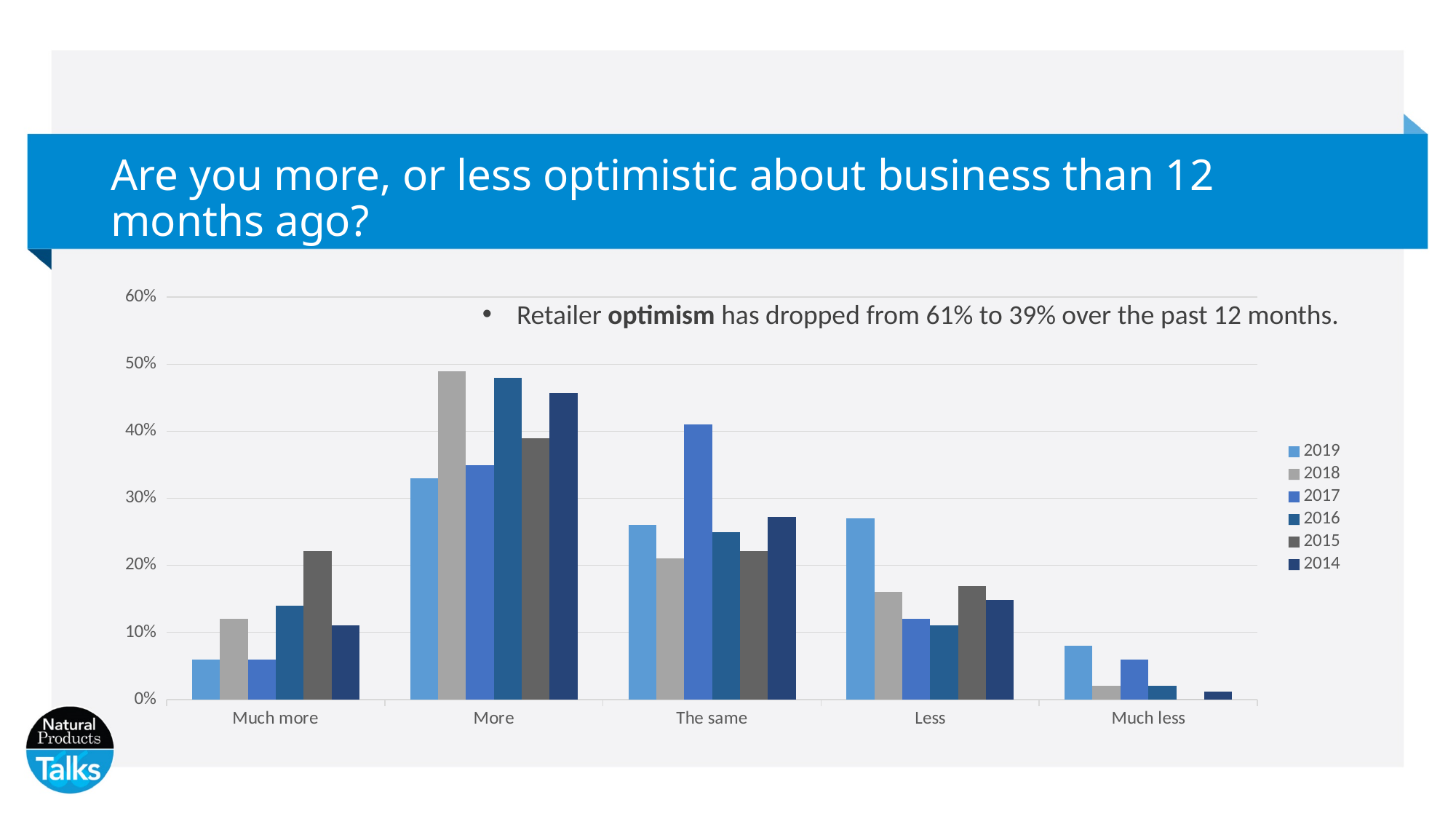
Is the value for 2019 in the 'More' category greater or less than 30%? greater Which category has the tallest bars overall in the chart? More What kind of chart is shown on the slide? bar chart In the 'More' category, which is larger: the value for 2019 or the value for 2018? 2018 What question is the chart's title asking? Are you more, or less optimistic about business than 12 months ago? In the 'Much more' category, which year has the highest value? 2015 In the 'Much less' category, which year has the lowest value? 2015 How many series does the chart's legend list? 6 In the 'The same' category, which year has the highest value? 2017 Is the value for 2019 in the 'Much less' category greater or less than 10%? less How many categories are shown on the x axis of the chart? 5